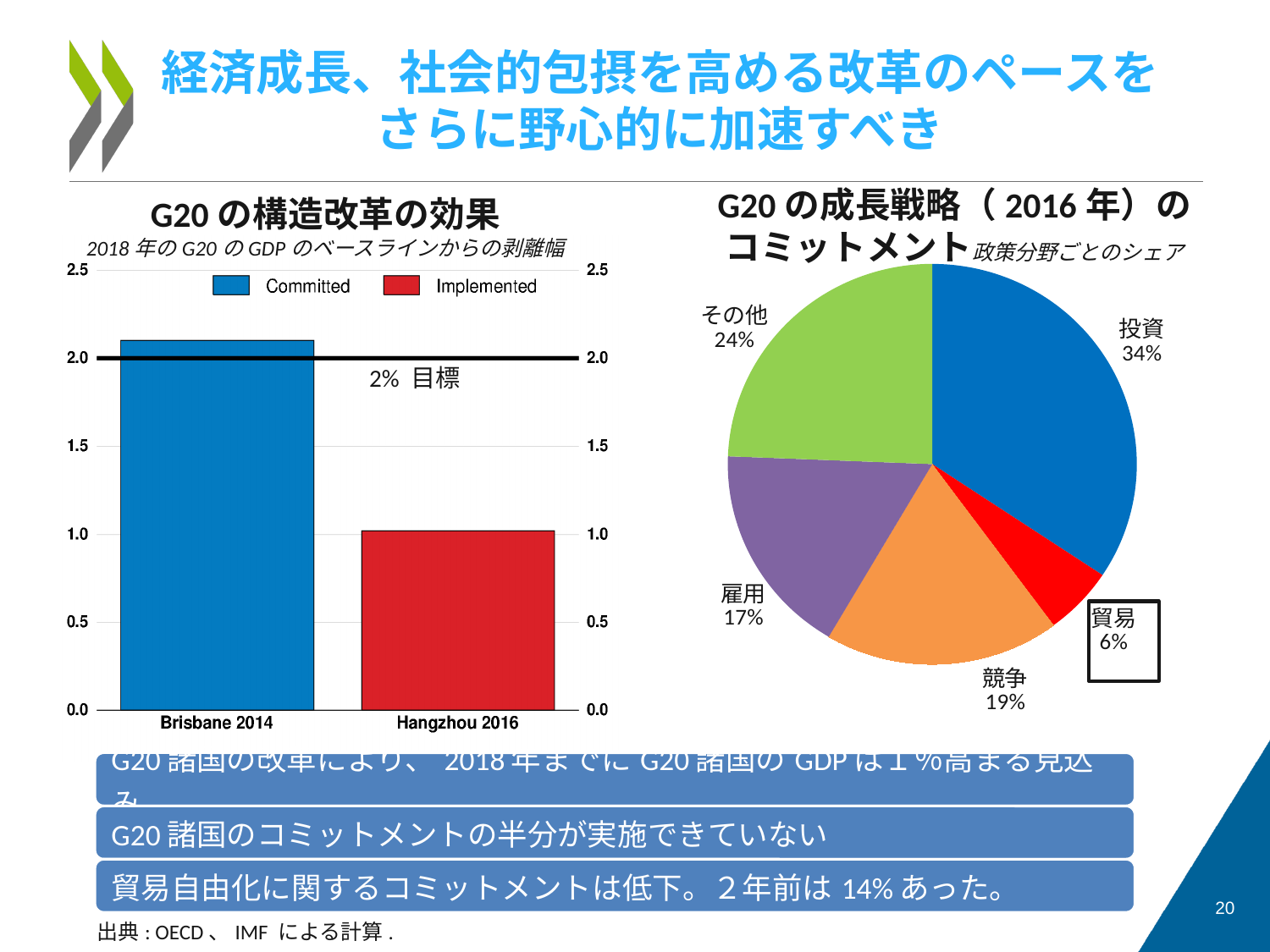
How many series does the legend of the bar chart on the left list? 2 In the pie chart on the right, what is the difference between the shares of その他 and 競争? 5% In the pie chart on the right, what share does 投資 have? 34% In the pie chart on the right, which policy area has the largest share? 投資 In the pie chart on the right, what share does 雇用 have? 17% In the pie chart on the right, which policy area has the smallest share? 貿易 In the bar chart on the left, is the value for Hangzhou 2016 greater or less than 1.5? less In the bar chart on the left, which bar is taller, Brisbane 2014 or Hangzhou 2016? Brisbane 2014 In the pie chart on the right, which is larger, the share of 競争 or the share of 雇用? 競争 How many slices does the pie chart on the right have? 5 In the bar chart on the left, is the value for Brisbane 2014 greater or less than 2.0? greater In the pie chart on the right, what share does 貿易 have? 6%